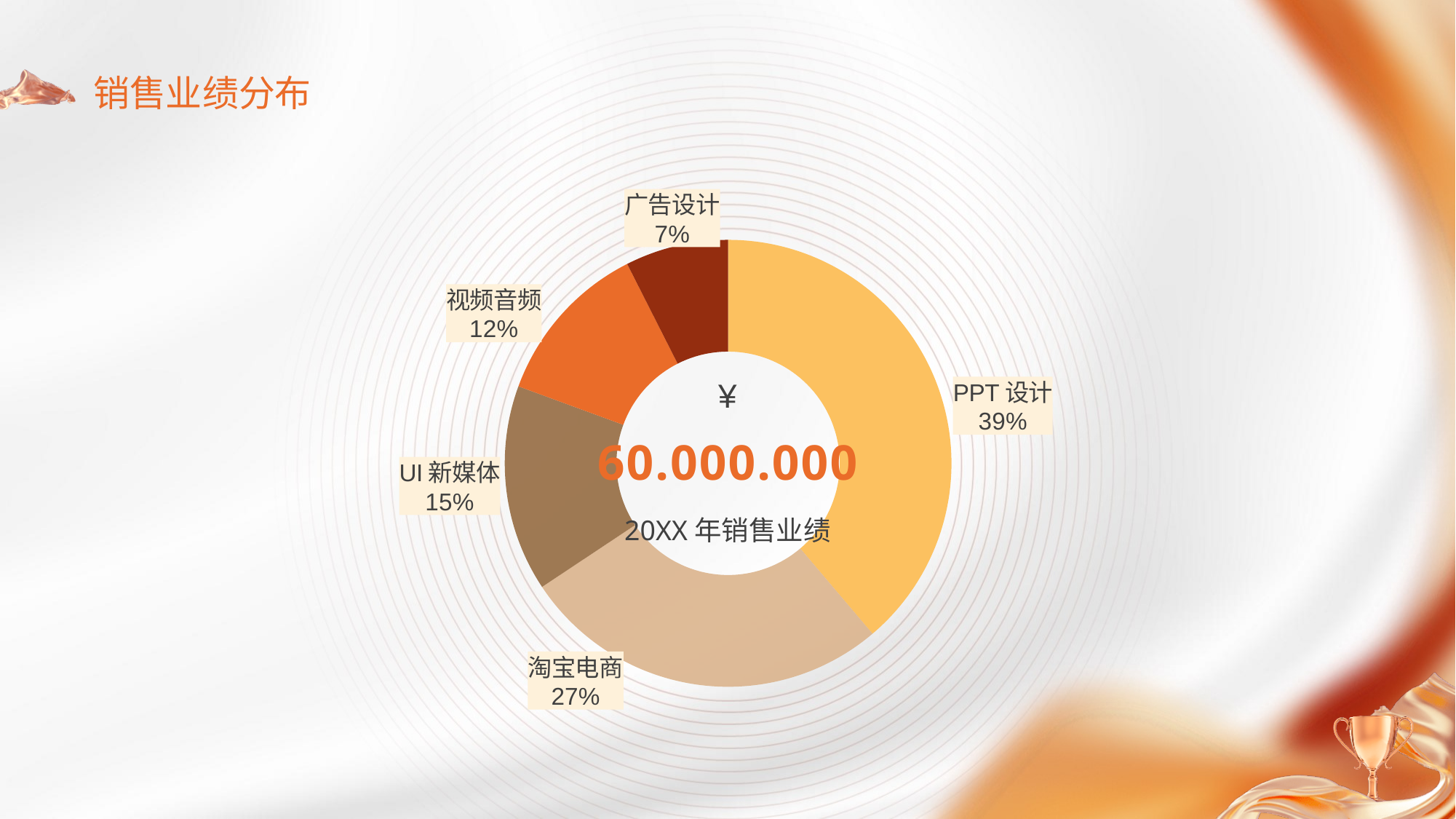
How many categories are shown in the pie chart? 5 Which category has the largest share of the pie? PPT 设计 What share of the pie does 广告设计 hold? 7% What is the difference in share between PPT 设计 and 淘宝电商? 12% What share of the pie does 视频音频 hold? 12% What share of the pie does 淘宝电商 hold? 27% What share of the pie does PPT 设计 hold? 39% What share of the pie does UI 新媒体 hold? 15% What total sales figure is printed in the centre of the chart? 60.000.000 Which has a larger share, UI 新媒体 or 视频音频? UI 新媒体 Which category has the smallest share of the pie? 广告设计 What kind of chart is shown on the slide? Pie chart (doughnut)